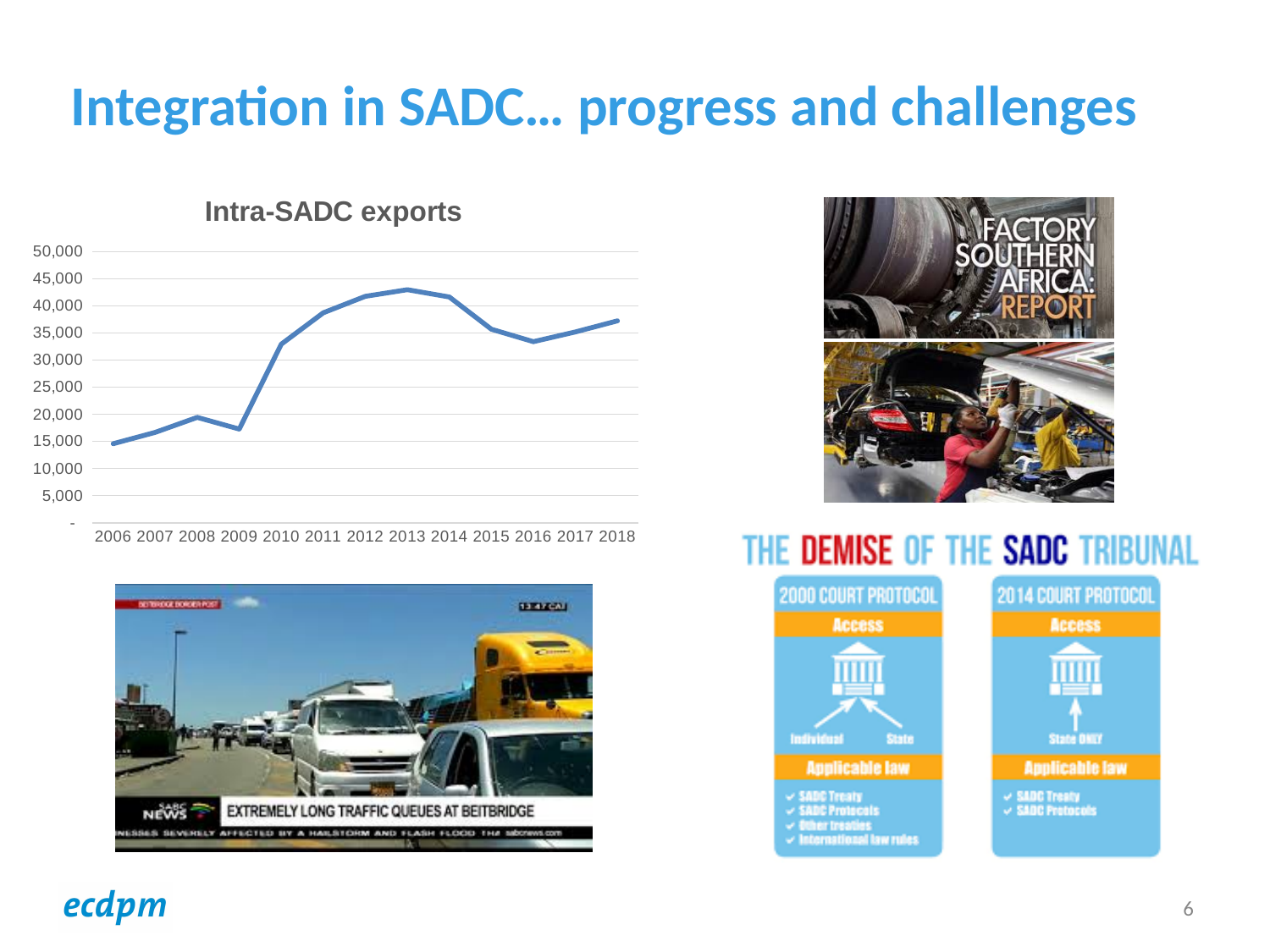
In which year are Intra-SADC exports highest? 2013 Is the value for Intra-SADC exports in 2018 greater or less than 35,000? greater Which year has higher Intra-SADC exports, 2009 or 2010? 2010 Is the value for Intra-SADC exports in 2006 greater or less than 20,000? less Is the value for Intra-SADC exports in 2010 greater or less than 30,000? greater How many years are plotted on the Intra-SADC exports chart? 13 In which year are Intra-SADC exports lowest? 2006 Which year has higher Intra-SADC exports, 2013 or 2018? 2013 Do Intra-SADC exports rise or fall between 2013 and 2016? fall What is the title of the chart on the slide? Intra-SADC exports What type of chart is used to show Intra-SADC exports? line chart